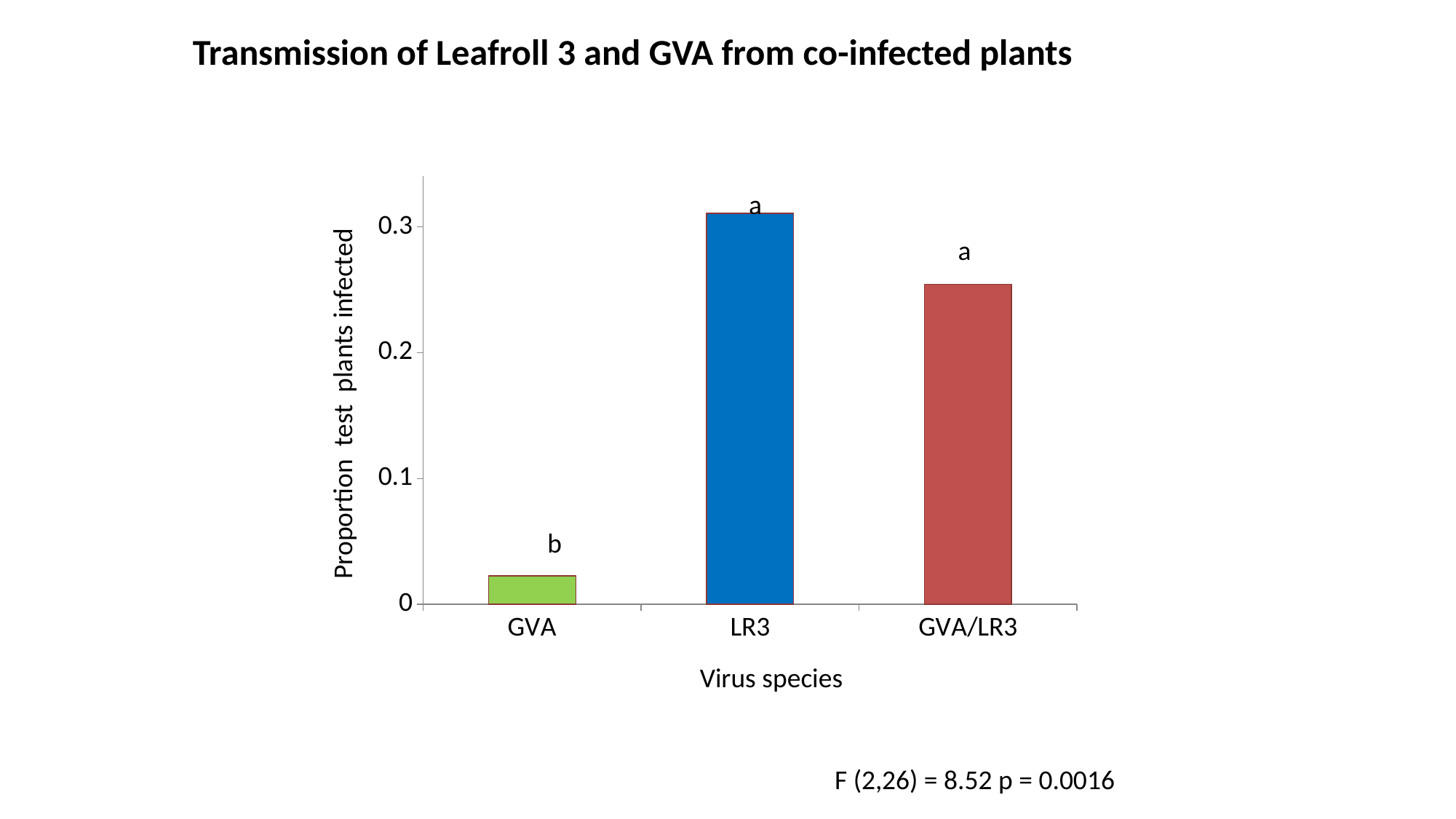
How many virus species categories are plotted on the x axis? 3 Is the value for GVA/LR3 greater or less than 0.2? greater Which has a higher proportion of test plants infected, LR3 or GVA/LR3? LR3 Which virus species has the highest proportion of test plants infected? LR3 What is the title of the chart? Transmission of Leafroll 3 and GVA from co-infected plants What kind of chart is shown on the slide? bar chart What is the label of the y axis? Proportion test plants infected Which virus species has the lowest proportion of test plants infected? GVA Is the value for LR3 greater or less than 0.2? greater Is the value for GVA greater or less than 0.1? less Which has a higher proportion of test plants infected, GVA or GVA/LR3? GVA/LR3